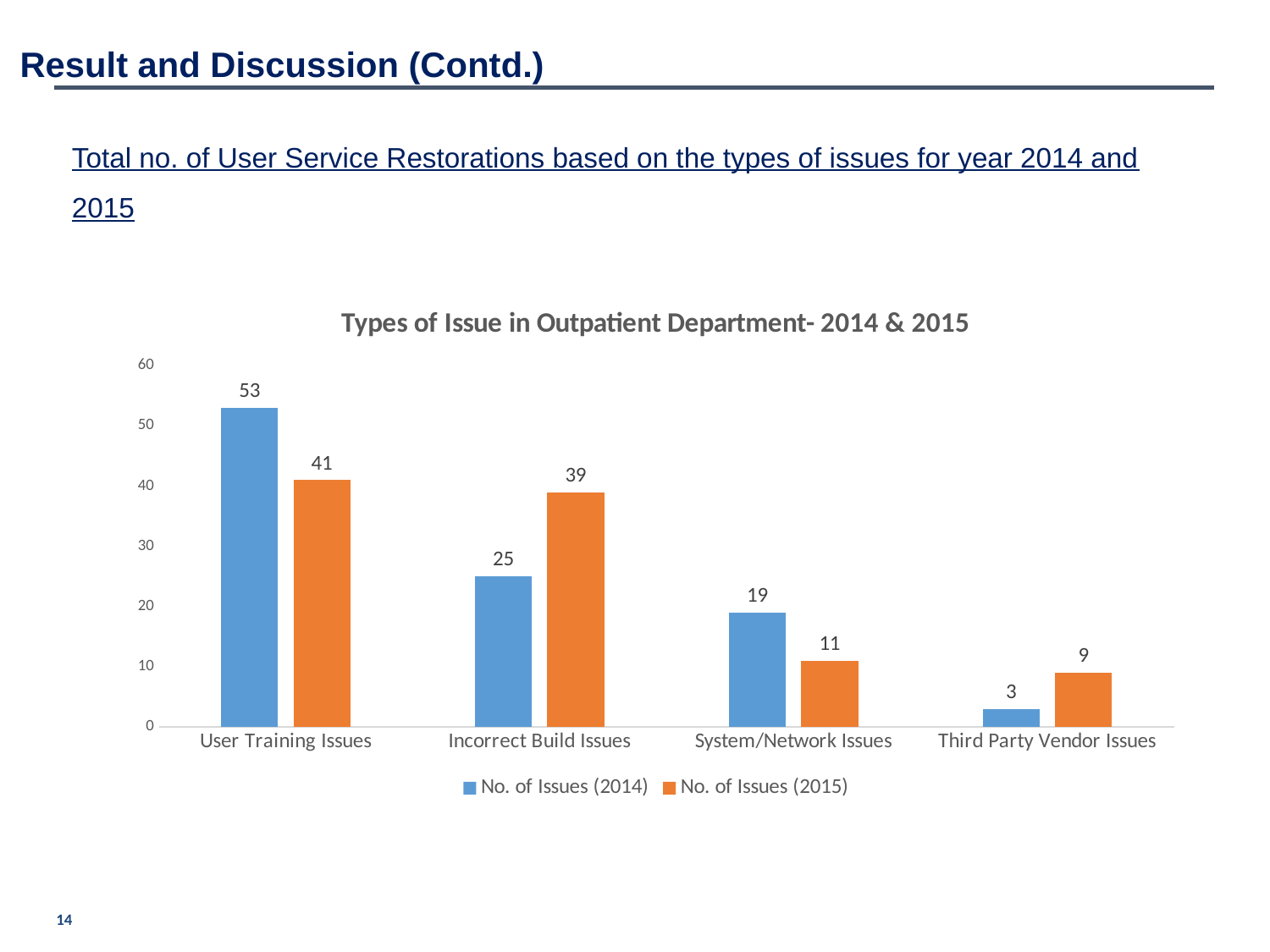
What is the difference between the 2014 and 2015 values for User Training Issues? 12 How many issue categories are shown on the x axis? 4 Which category has the highest number of issues in 2015? User Training Issues Which category has the lowest number of issues in 2014? Third Party Vendor Issues Which is larger for Incorrect Build Issues: the 2014 value or the 2015 value? No. of Issues (2015) What is the number of issues in 2015 for Incorrect Build Issues? 39 What is the number of issues in 2014 for User Training Issues? 53 What kind of chart is shown on the slide? Bar chart Do the 2014 values rise or fall from left to right across the categories? Fall What is the title of the chart? Types of Issue in Outpatient Department- 2014 & 2015 What is the number of issues in 2014 for Third Party Vendor Issues? 3 How many series does the legend list? 2